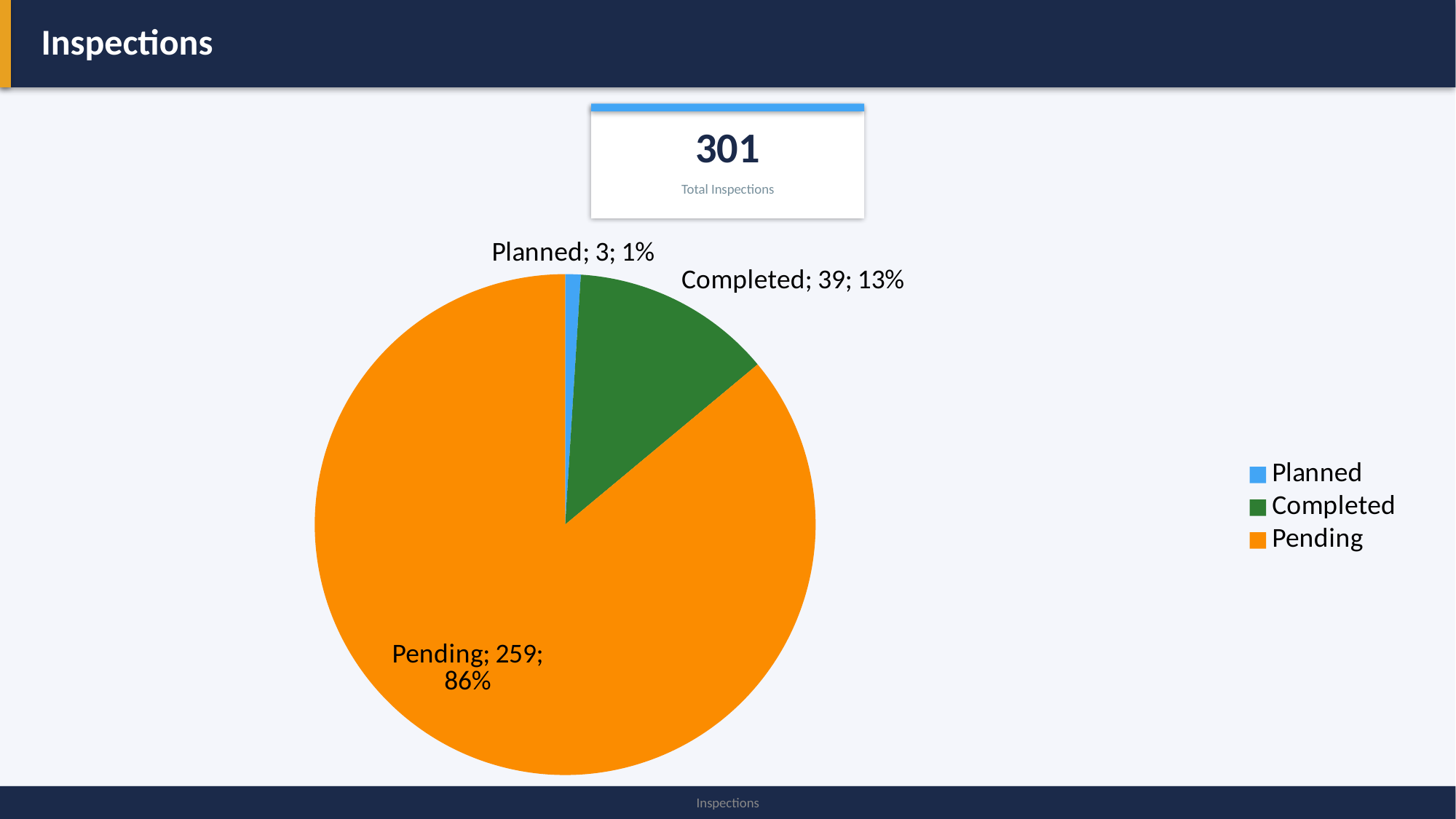
Which is larger, the number of Completed inspections or the number of Planned inspections? Completed How many inspections are Planned? 3 What share of the pie does the Pending slice represent? 86% What is the difference between the number of Pending and Completed inspections? 220 Which category has the smallest slice of the pie? Planned How many categories does the pie chart show? 3 What is the total number of inspections shown in the box above the chart? 301 How many inspections are Completed? 39 Which category has the largest slice of the pie? Pending How many inspections are Pending? 259 What kind of chart is shown on the slide? pie chart What share of the pie does the Completed slice represent? 13%